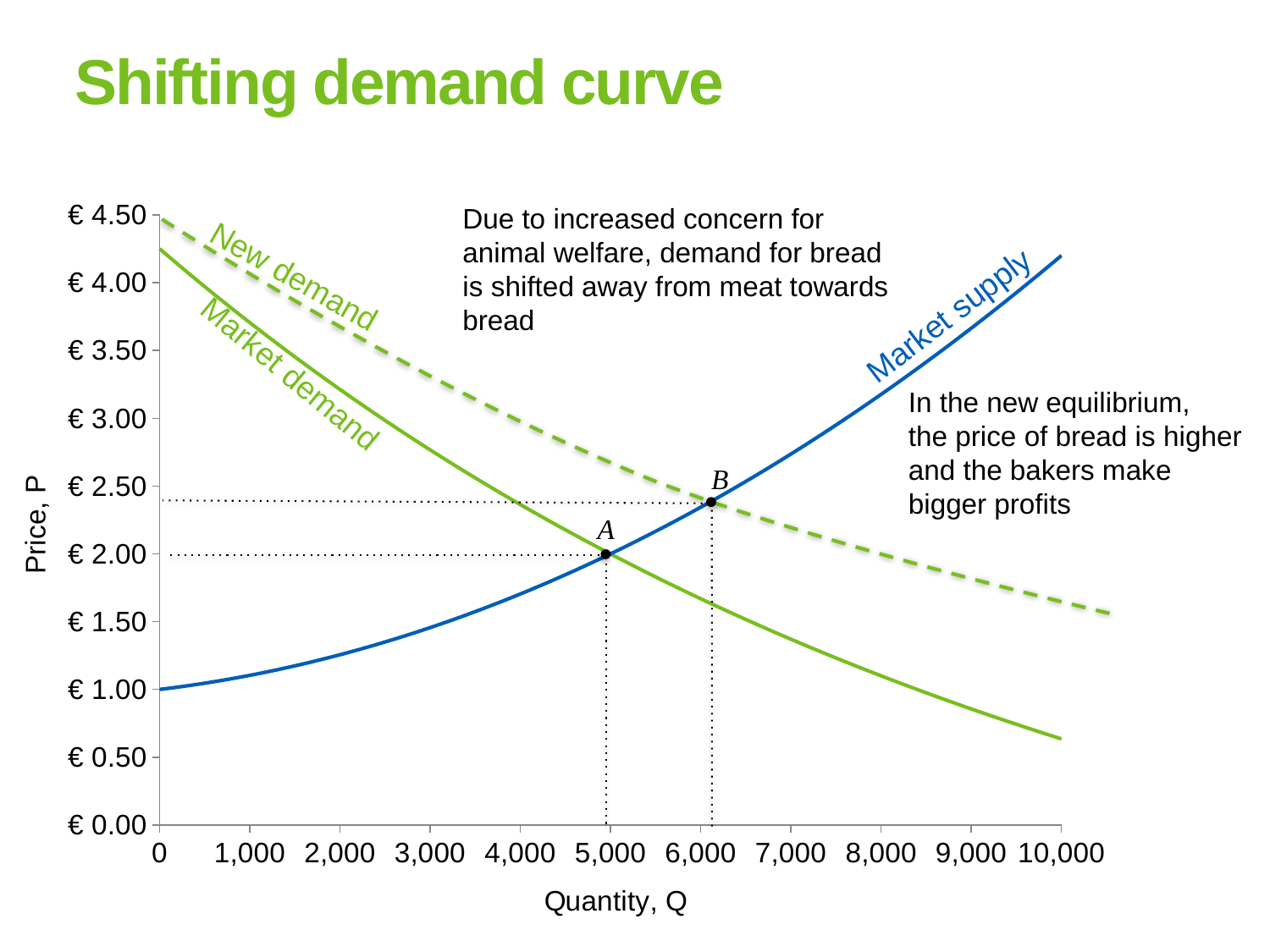
Is the price at point B greater or less than € 2.00? greater What kind of chart is shown on the slide? line chart Which equilibrium point has the higher price, A or B? B What is the price at equilibrium point A? € 2.00 How many curves are plotted on the chart? 3 Is the price at point B greater or less than € 2.50? less Does the Market demand curve rise or fall as quantity increases? falls What is the price on the Market supply curve at a quantity of 0? € 1.00 Is the quantity at point B greater or less than 6,000? greater Which curve is drawn as a dashed line? New demand Does the Market supply curve rise or fall as quantity increases? rises